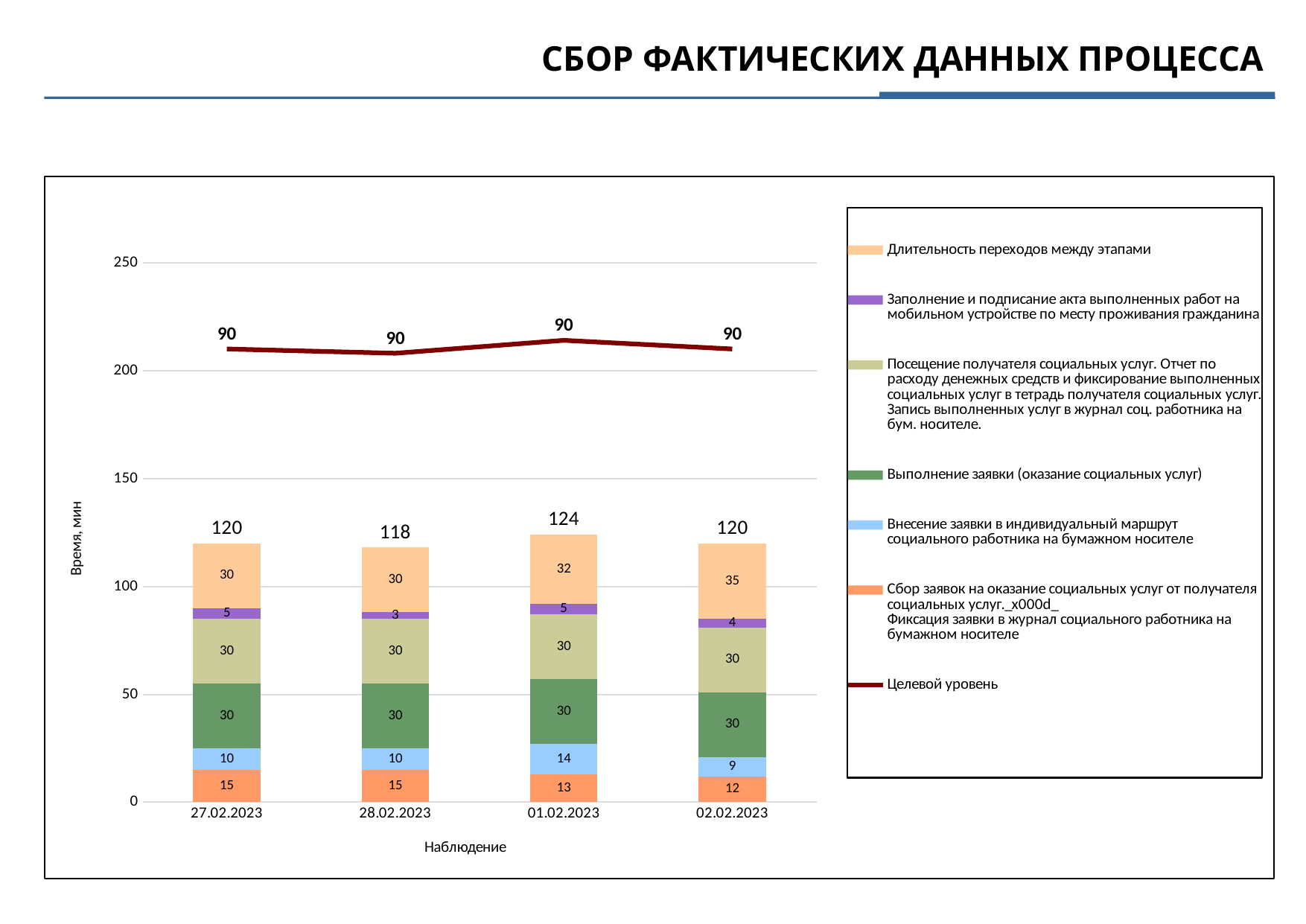
What is the difference between the stacked bar totals for 01.02.2023 and 28.02.2023? 6 What is the total of the stacked bar for 01.02.2023? 124 What is the label of the y axis? Время, мин Which observation date has the lowest stacked bar total? 28.02.2023 What is the value of the 'Длительность переходов между этапами' segment for 02.02.2023? 35 What is the total of the stacked bar for 28.02.2023? 118 What is the value of the 'Внесение заявки в индивидуальный маршрут социального работника на бумажном носителе' segment for 01.02.2023? 14 How many observation dates are shown on the x axis? 4 What is the value of the 'Целевой уровень' line for 27.02.2023? 90 Which is larger: the 'Сбор заявок' segment for 27.02.2023 or for 02.02.2023? 27.02.2023 Which observation date has the highest stacked bar total? 01.02.2023 How many entries does the legend list? 7